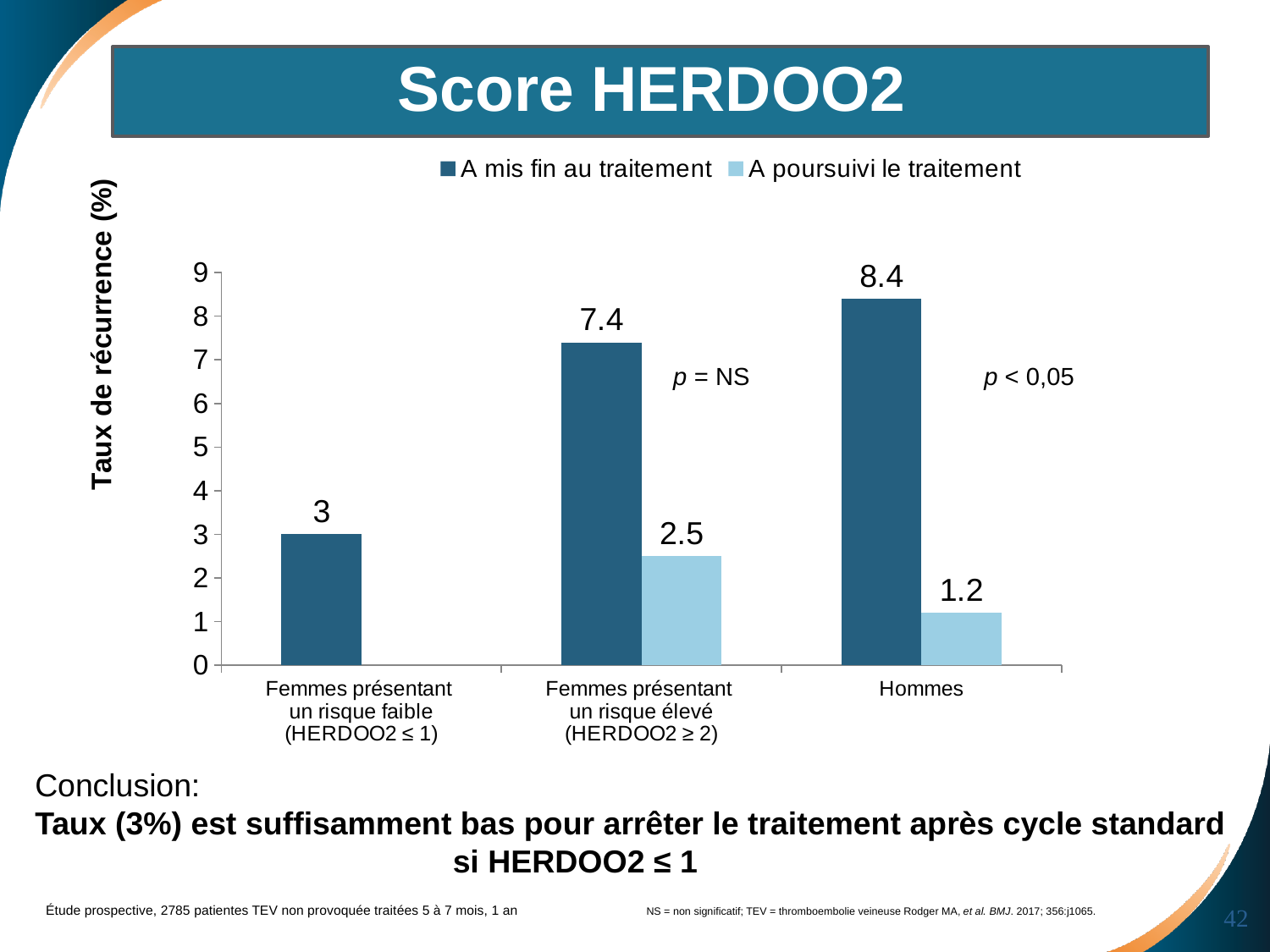
What is the difference between 'A mis fin au traitement' and 'A poursuivi le traitement' for Femmes présentant un risque élevé (HERDOO2 ≥ 2)? 4.9 What is the difference between 'A mis fin au traitement' and 'A poursuivi le traitement' for Hommes? 7.2 Which category has the lowest value for 'A mis fin au traitement'? Femmes présentant un risque faible (HERDOO2 ≤ 1) Which category has the highest value for 'A mis fin au traitement'? Hommes How many series does the legend list? 2 What is the recurrence rate for 'A mis fin au traitement' among Femmes présentant un risque faible (HERDOO2 ≤ 1)? 3 What is the title of the chart? Score HERDOO2 What is the recurrence rate for 'A poursuivi le traitement' among Femmes présentant un risque élevé (HERDOO2 ≥ 2)? 2.5 What is the recurrence rate for 'A mis fin au traitement' among Hommes? 8.4 Which is larger for Femmes présentant un risque élevé (HERDOO2 ≥ 2): 'A mis fin au traitement' or 'A poursuivi le traitement'? A mis fin au traitement What kind of chart is shown on the slide? Bar chart What is the recurrence rate for 'A poursuivi le traitement' among Hommes? 1.2